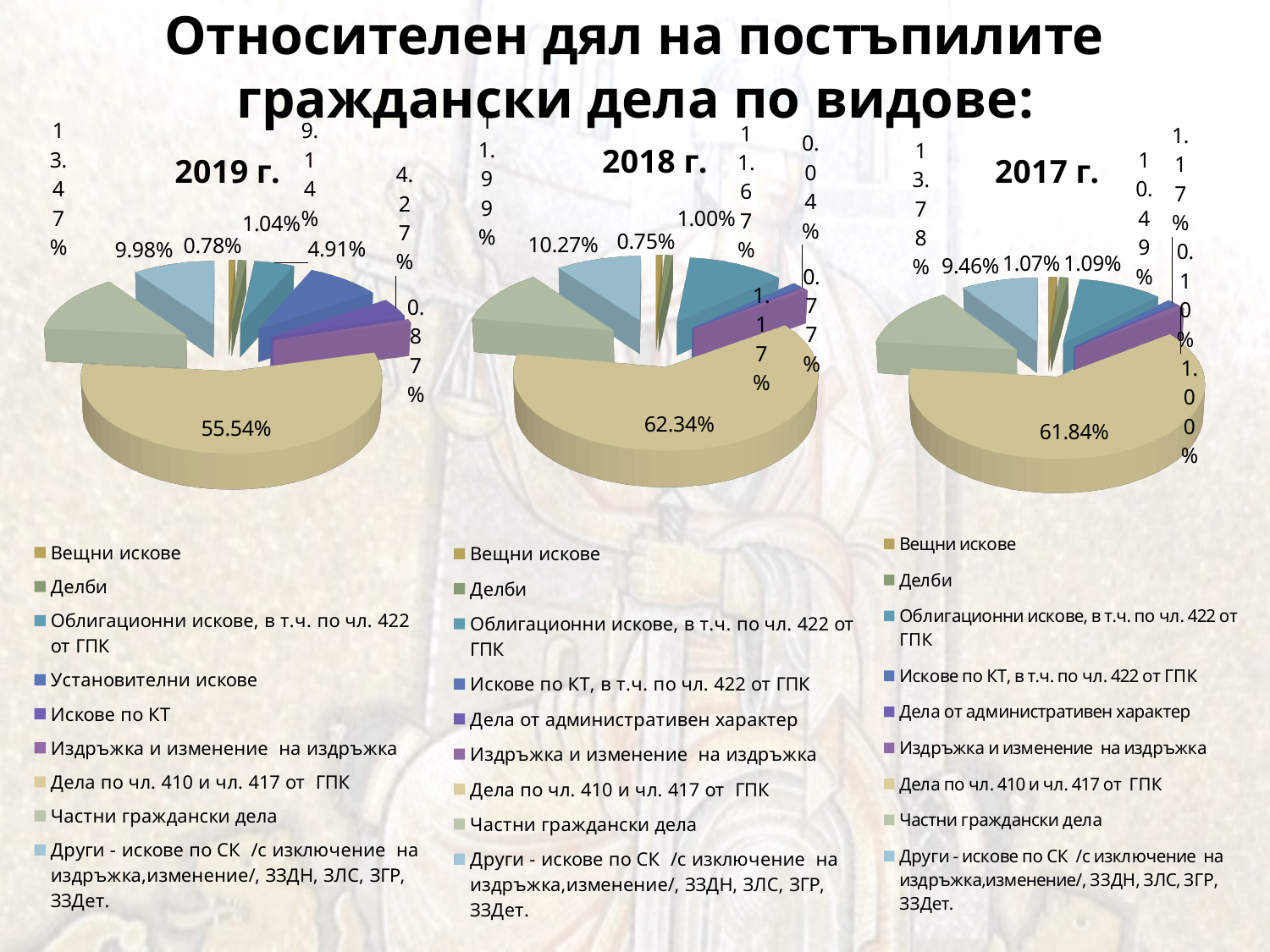
In the 2017 г. pie chart, is the largest slice greater or less than 50%? greater In the 2019 г. pie chart, which category has the largest slice? Дела по чл. 410 и чл. 417 от ГПК What is the difference between the largest slice in the 2018 г. chart (62.34%) and the largest slice in the 2019 г. chart (55.54%)? 6.80% What is the title of the slide containing the three pie charts? Относителен дял на постъпилите граждански дела по видове: How many pie charts are shown on the slide? 3 In the 2017 г. pie chart, what is the largest share shown? 61.84% How many categories does the legend of the 2018 г. pie chart list? 9 What kind of chart is used for the 2019 г. data? pie chart In the 2019 г. pie chart, what is the largest share shown? 55.54% What is the difference between the largest slice in the 2017 г. chart (61.84%) and the largest slice in the 2019 г. chart (55.54%)? 6.30% Which is larger: the largest slice in the 2018 г. chart or the largest slice in the 2019 г. chart? 2018 г. (62.34%)